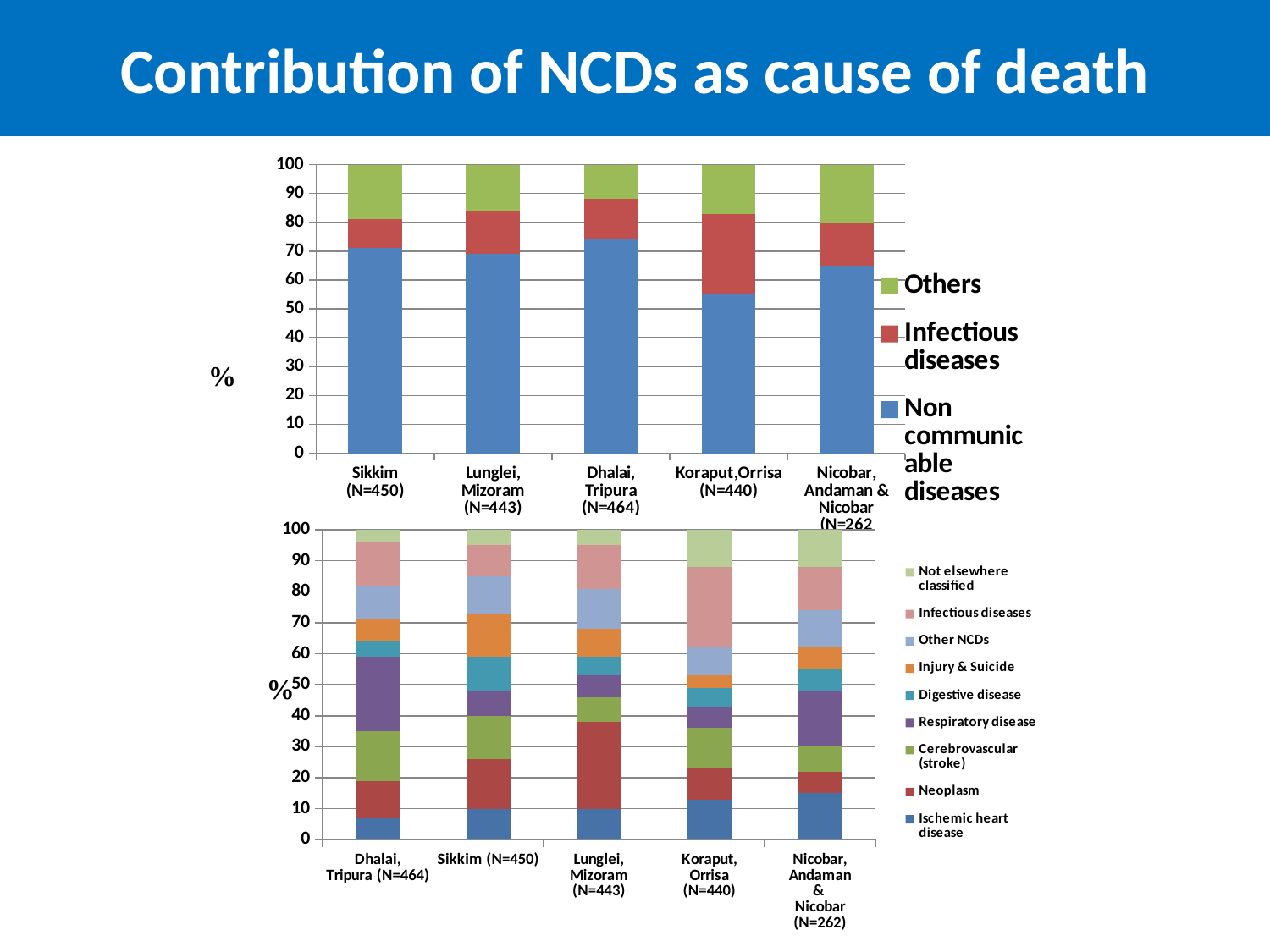
In the bottom chart, which site has the largest Neoplasm segment? Lunglei, Mizoram (N=443) In the top chart, which site has the largest share of Infectious diseases? Koraput,Orrisa (N=440) In the top chart, which is larger: the Non communicable diseases share for Sikkim or for Koraput,Orrisa? Sikkim What is the title of the slide? Contribution of NCDs as cause of death How many sites (categories) are shown on the x axis of the top chart? 5 In the top chart, is the Non communicable diseases value for Nicobar, Andaman & Nicobar greater or less than 60? greater How many series does the legend of the top chart list? 3 In the top chart, is the Non communicable diseases value for Koraput,Orrisa greater or less than 60? less In the bottom chart, is the Ischemic heart disease value for Dhalai, Tripura greater or less than 10? less How many series does the legend of the bottom chart list? 9 In the top chart, which site has the lowest share of Non communicable diseases? Koraput,Orrisa (N=440) What kind of chart is the top chart on the slide? Stacked bar chart